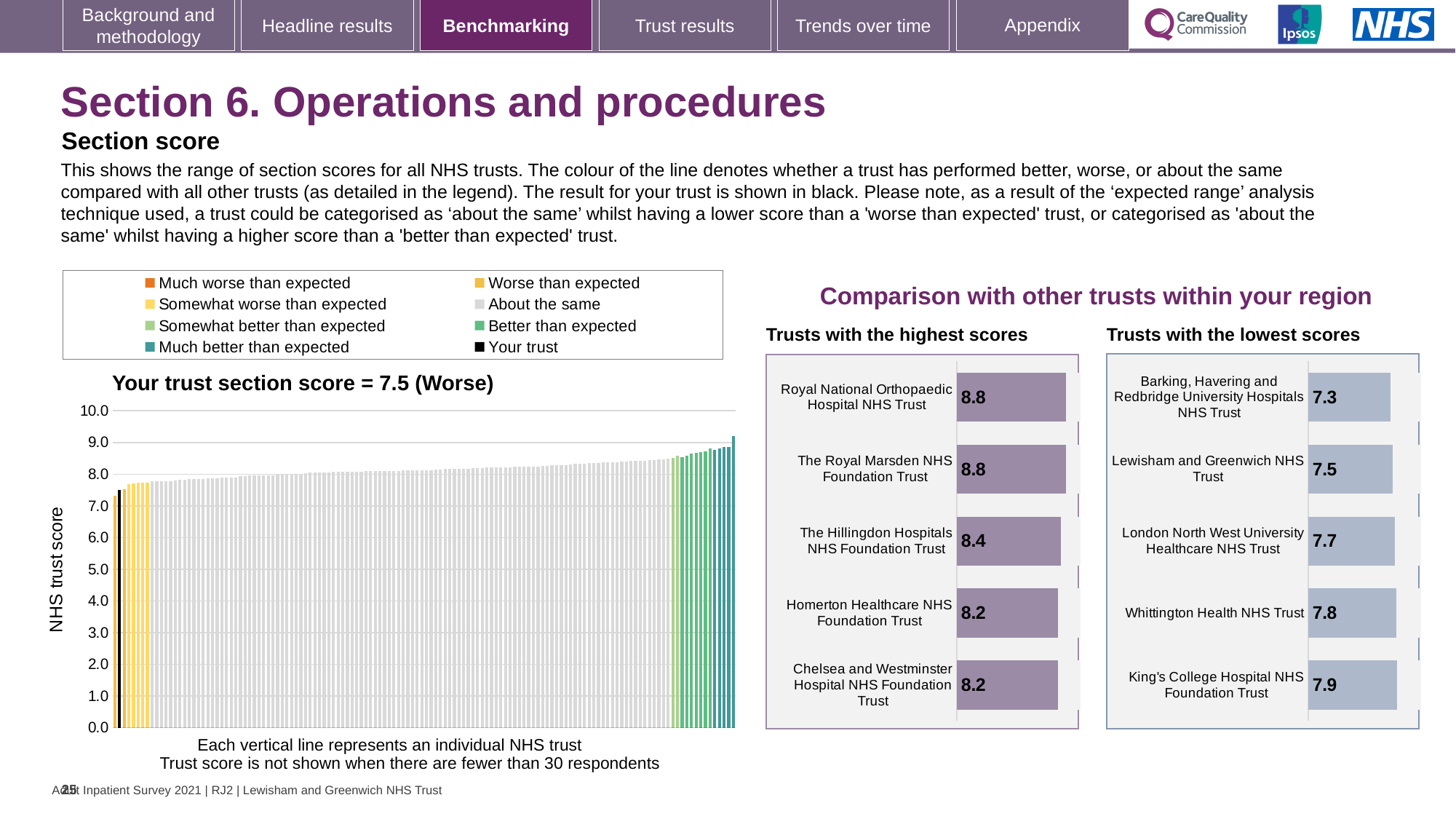
In the 'Trusts with the lowest scores' chart, which trust has the lowest score? Barking, Havering and Redbridge University Hospitals NHS Trust What is the y-axis label of the 'Your trust section score' chart? NHS trust score In the 'Your trust section score' chart, do the bars rise or fall from left to right along the x axis? rise In the 'Trusts with the lowest scores' chart, which has the larger score: Whittington Health NHS Trust or London North West University Healthcare NHS Trust? Whittington Health NHS Trust In the 'Trusts with the lowest scores' chart, what is the difference between the score for King's College Hospital NHS Foundation Trust and the score for Lewisham and Greenwich NHS Trust? 0.4 How many entries does the legend above the 'Your trust section score' chart list? 8 In the 'Trusts with the highest scores' chart, what is the score for The Hillingdon Hospitals NHS Foundation Trust? 8.4 In the 'Trusts with the lowest scores' chart, what is the score for King's College Hospital NHS Foundation Trust? 7.9 In the 'Trusts with the highest scores' chart, how many trusts are shown? 5 What kind of chart is the 'Your trust section score' chart? bar chart In the 'Your trust section score' chart, what is the section score for your trust? 7.5 In the 'Trusts with the highest scores' chart, what is the difference between the score for Royal National Orthopaedic Hospital NHS Trust and the score for Homerton Healthcare NHS Foundation Trust? 0.6